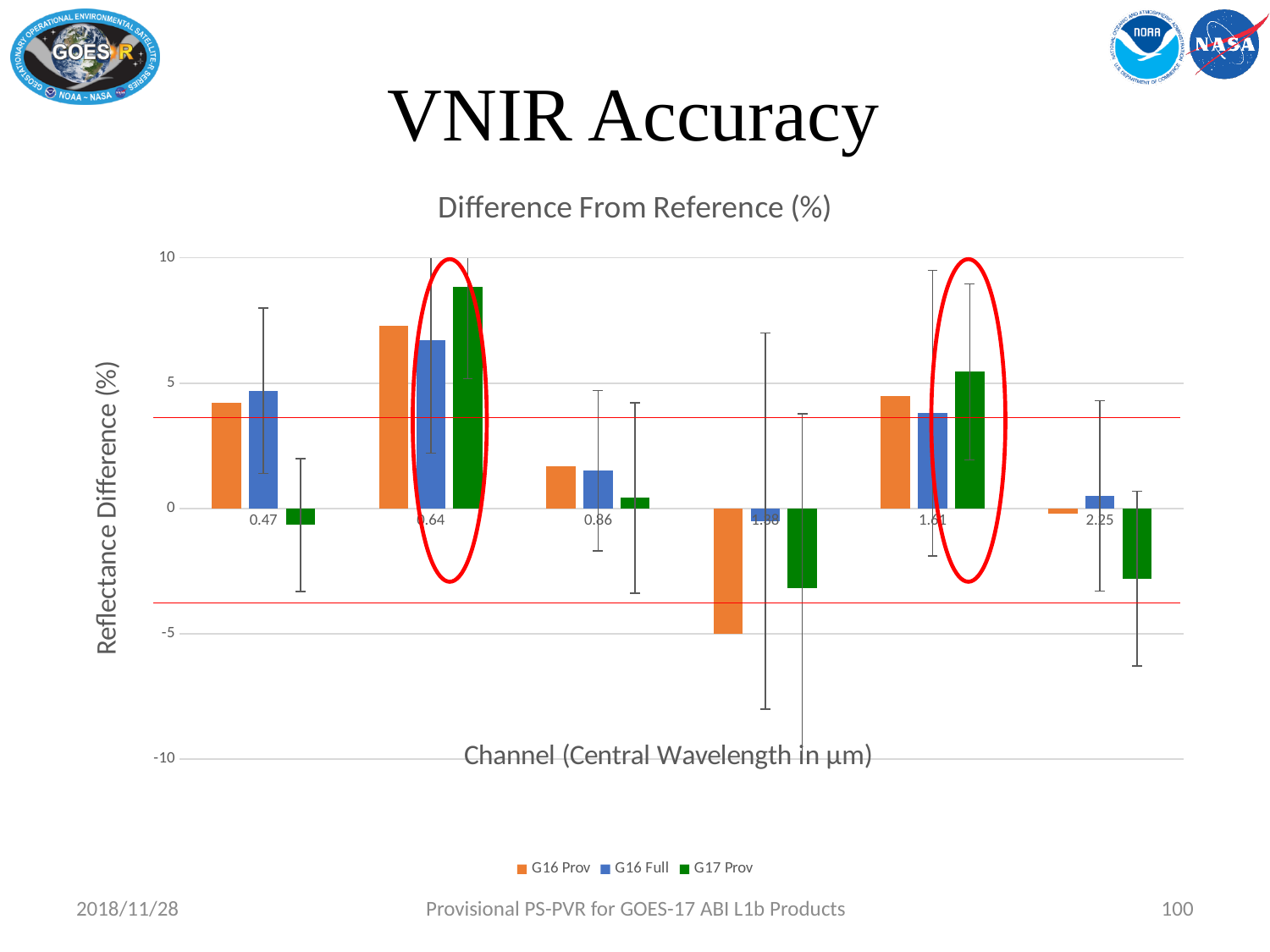
What kind of chart is shown on the slide? bar chart Which series and channel has the lowest bar in the chart? G16 Prov at 1.38 At channel 0.47, which is larger: the G16 Prov value or the G17 Prov value? G16 Prov What is the title of the chart? Difference From Reference (%) Is the value for G17 Prov at channel 0.64 greater or less than 5? greater Is the value for G16 Prov at channel 0.64 greater or less than 5? greater What is the label of the vertical axis? Reflectance Difference (%) Which series and channel has the highest bar in the chart? G17 Prov at 0.64 Is the value for G16 Prov at channel 0.47 greater or less than 5? less How many series does the legend list? 3 How many channel categories are plotted along the x axis? 6